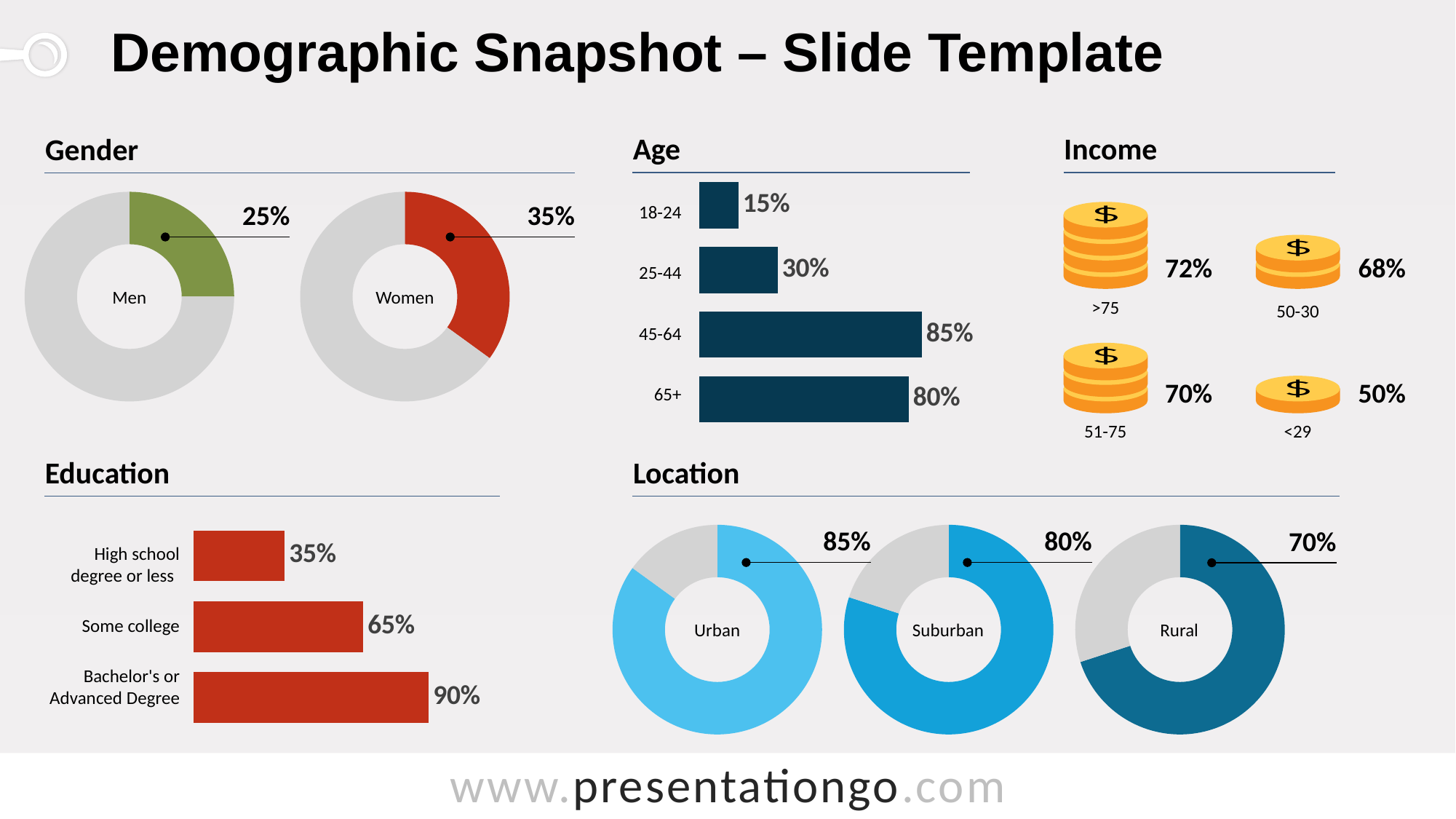
In the Gender section, what is the value shown for Women? 35% In the Age chart, what is the difference between the 45-64 and 25-44 values? 55% In the Gender section, which is larger, the value for Men or for Women? Women What kind of chart is the Education chart? bar chart In the Education chart, what is the value for Some college? 65% In the Age chart, how many age groups are shown? 4 In the Location section, what is the value shown for Rural? 70% In the Age chart, what is the value for the 45-64 group? 85% In the Income section, what is the value shown for the <29 group? 50% In the Age chart, which age group has the lowest value? 18-24 In the Education chart, which category has the highest value? Bachelor's or Advanced Degree In the Location section, what is the difference between the Urban and Suburban values? 5%